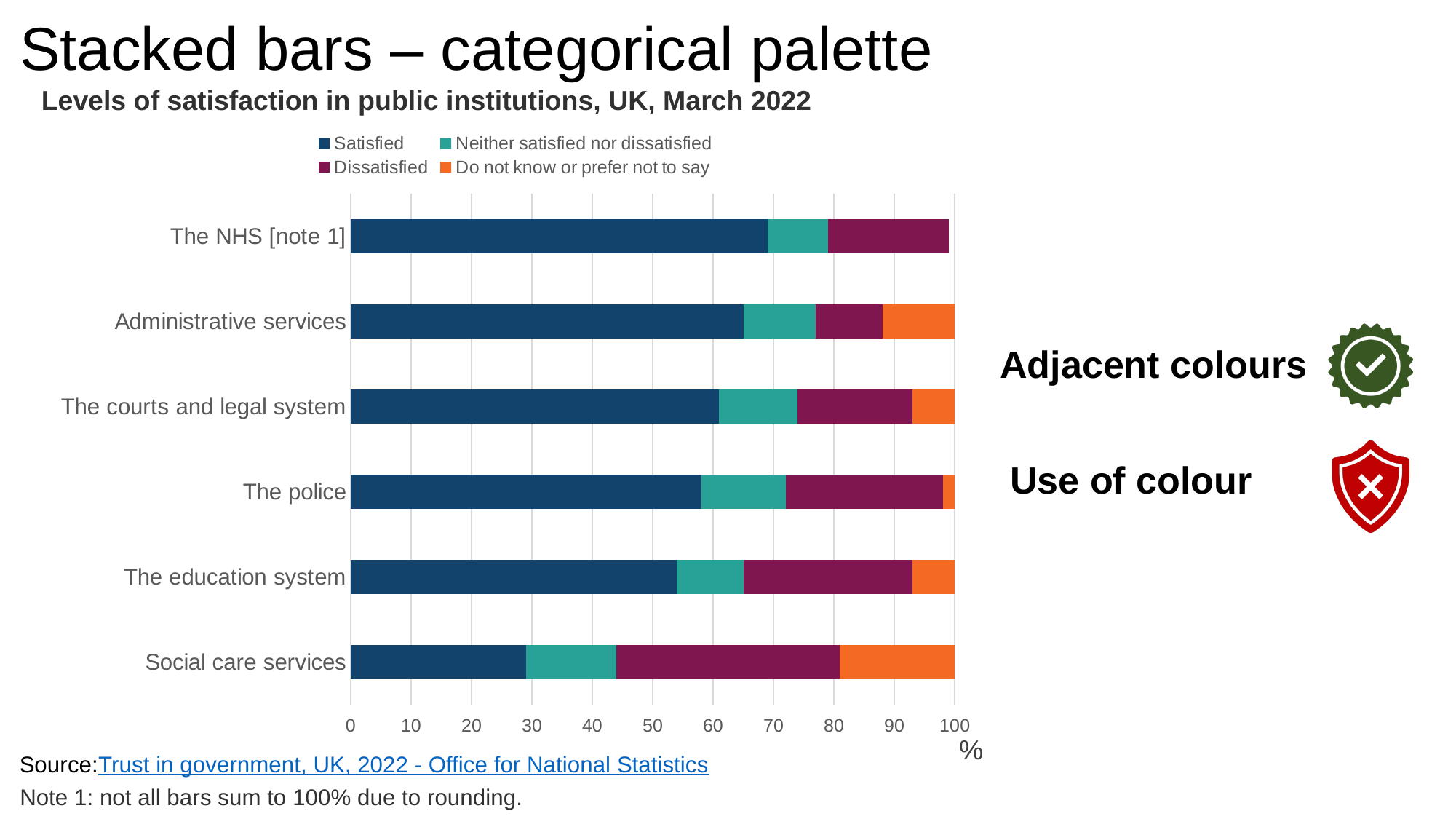
Is the Satisfied value for The NHS greater or less than 60? greater Which legend entry is shown in orange? Do not know or prefer not to say Which institution has the largest Dissatisfied segment? Social care services Is the Satisfied value for The education system greater or less than 50? greater Which institution has the lowest Satisfied value? Social care services How many public institutions are listed on the chart? 6 What kind of chart is shown on the slide? Bar chart Which institution has the highest Satisfied value? The NHS [note 1] How many series does the chart legend list? 4 Is the Satisfied value for Social care services greater or less than 40? less Which has a larger Satisfied value, The police or Social care services? The police What is the title of the chart? Levels of satisfaction in public institutions, UK, March 2022